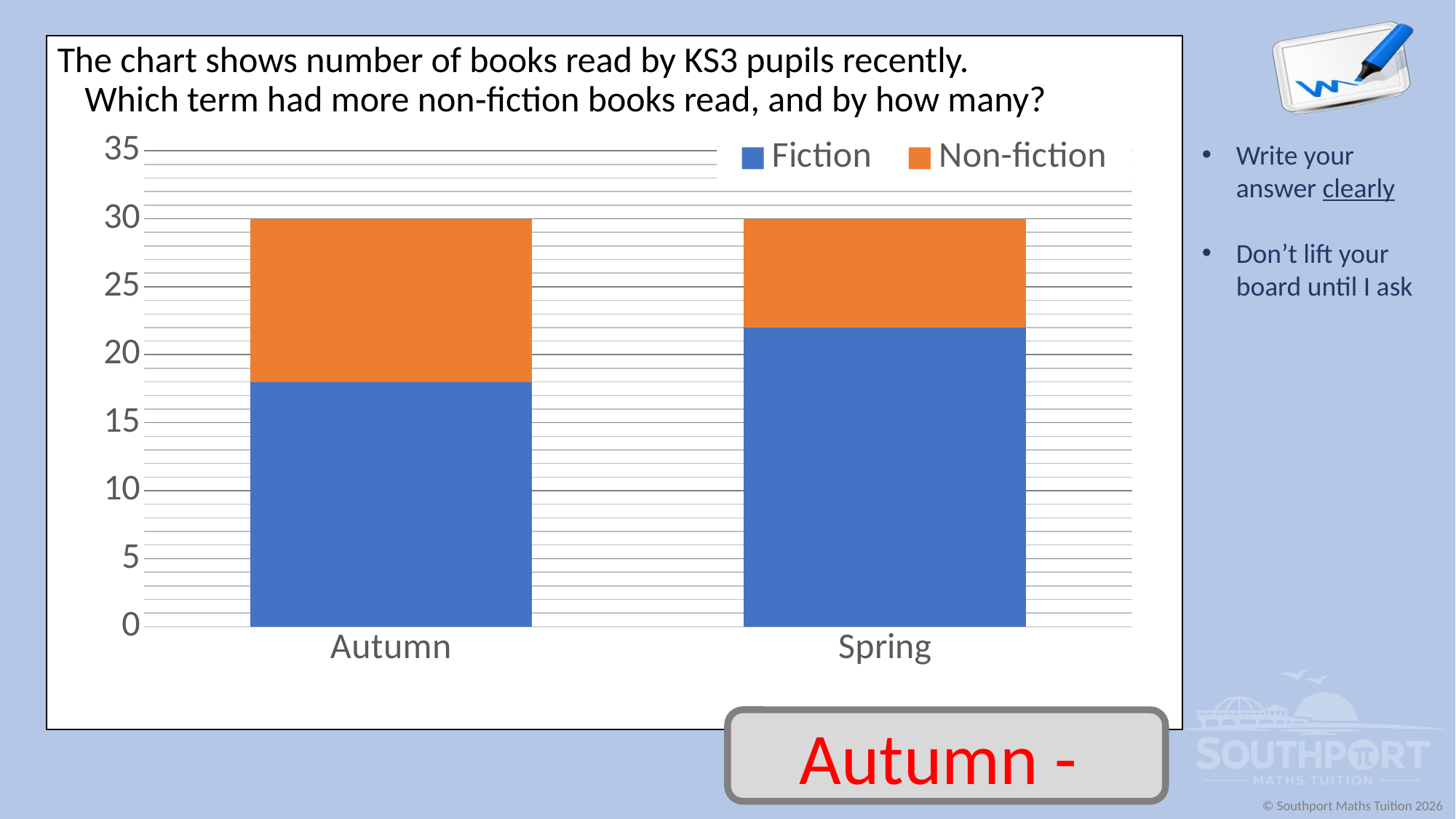
What is the total number of books read in Spring (the full height of the stacked bar)? 30 Which term had more Fiction books read, Autumn or Spring? Spring Which term had more Non-fiction books read, Autumn or Spring? Autumn Is the Fiction value for Autumn greater or less than 20? less Is the Non-fiction value for Spring greater or less than 10? less What are the two series named in the legend? Fiction and Non-fiction What kind of chart is shown on the slide? bar chart How many terms (categories) are shown on the x axis? 2 Which colour represents Non-fiction in the chart? orange Is the Fiction value for Spring greater or less than 20? greater How many series does the legend list? 2 What is the total number of books read in Autumn (the full height of the stacked bar)? 30